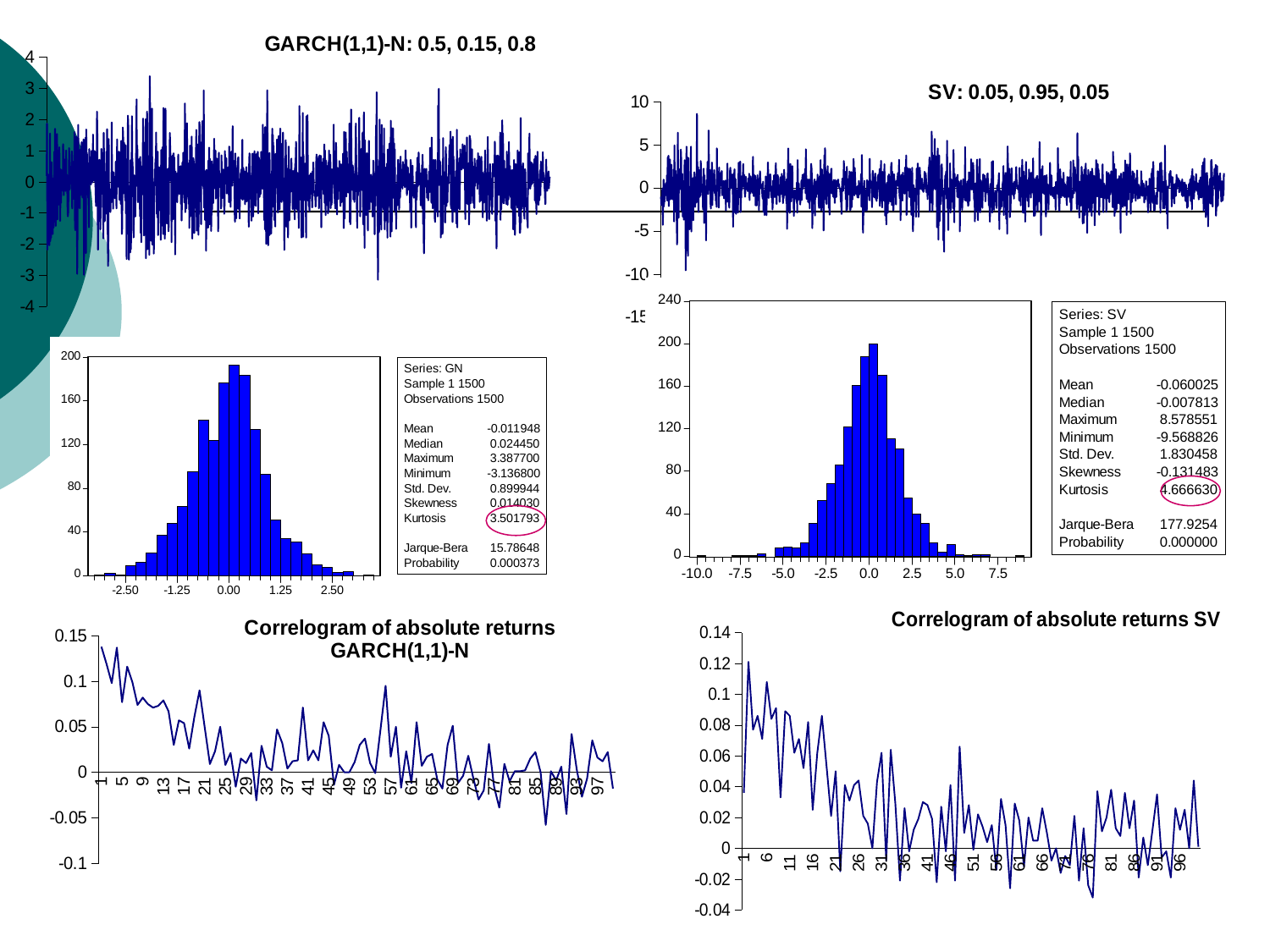
Which series has the larger Kurtosis, GN or SV? SV In the statistics box for Series: SV, what is the Kurtosis value? 4.666630 In the statistics box for Series: SV, what is the Maximum value? 8.578551 What is the title of the time series chart in the top right of the slide? SV: 0.05, 0.95, 0.05 What kind of chart is the 'Correlogram of absolute returns GARCH(1,1)-N' chart? line chart In the 'Correlogram of absolute returns SV' chart, is the value at lag 1 greater or less than 0.1? less In the 'Correlogram of absolute returns GARCH(1,1)-N' chart, do the values generally rise or fall as the lag increases along the x axis? fall How many observations are listed for Series: SV? 1500 In the statistics box for Series: GN, what is the Kurtosis value? 3.501793 What kind of chart is the histogram for Series: GN (the chart with the -2.50 to 2.50 x axis)? bar chart What is the difference between the Kurtosis of Series: SV and the Kurtosis of Series: GN? 1.164837 In the statistics box for Series: GN, what is the Std. Dev. value? 0.899944